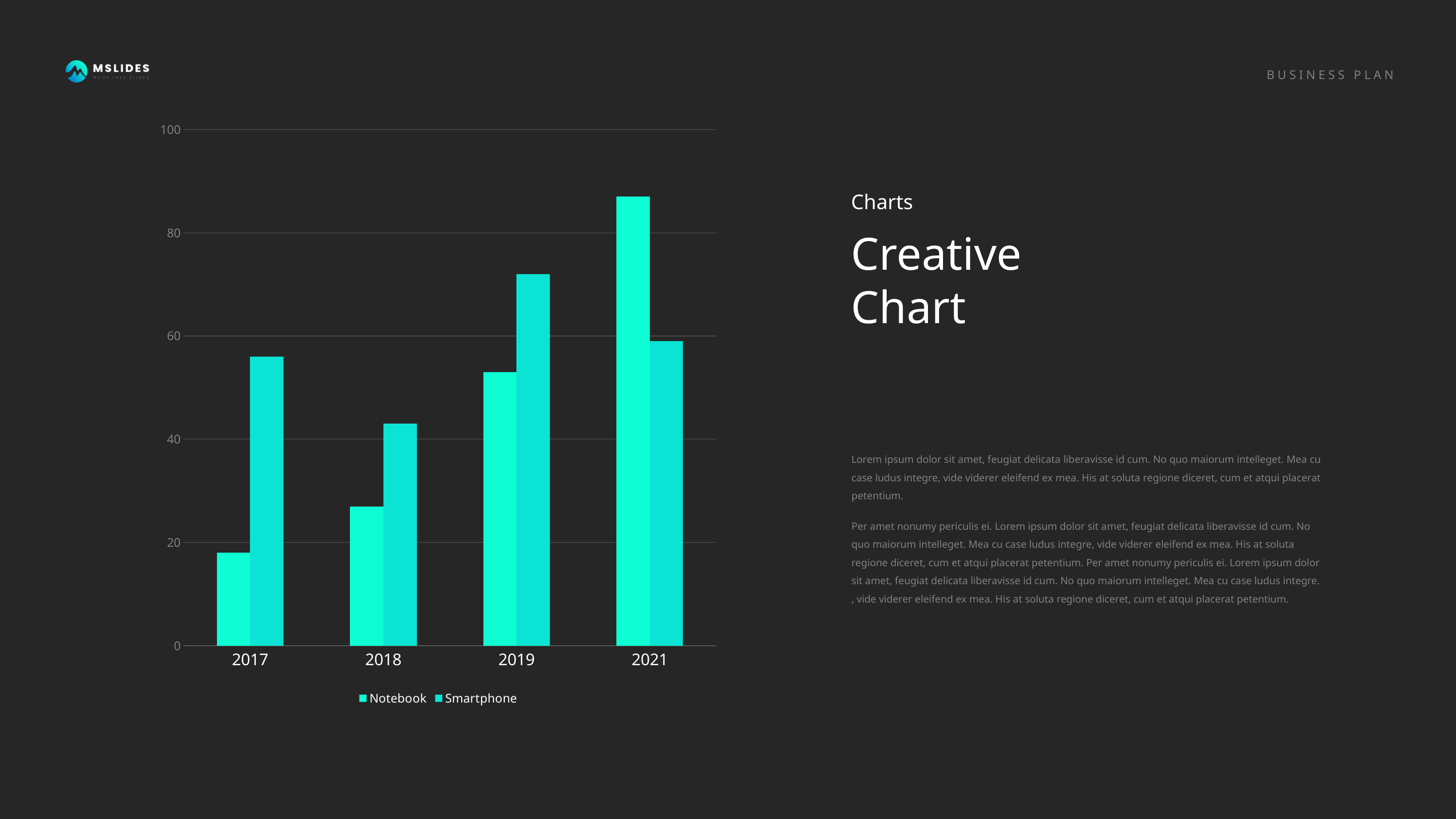
Which series are listed in the chart's legend? Notebook and Smartphone Which year has the highest Notebook value? 2021 Is the Smartphone value for 2018 greater or less than 40? greater Which year has the lowest Smartphone value? 2018 Is the Notebook value for 2021 greater or less than 80? greater How many series does the chart's legend list? 2 Do the Notebook values rise or fall from 2017 to 2021? rise How many categories are shown on the x axis of the chart? 4 In 2017, which is larger, the Notebook value or the Smartphone value? Smartphone What kind of chart is shown on the slide? bar chart Which year has the highest Smartphone value? 2019 Which year has the lowest Notebook value? 2017